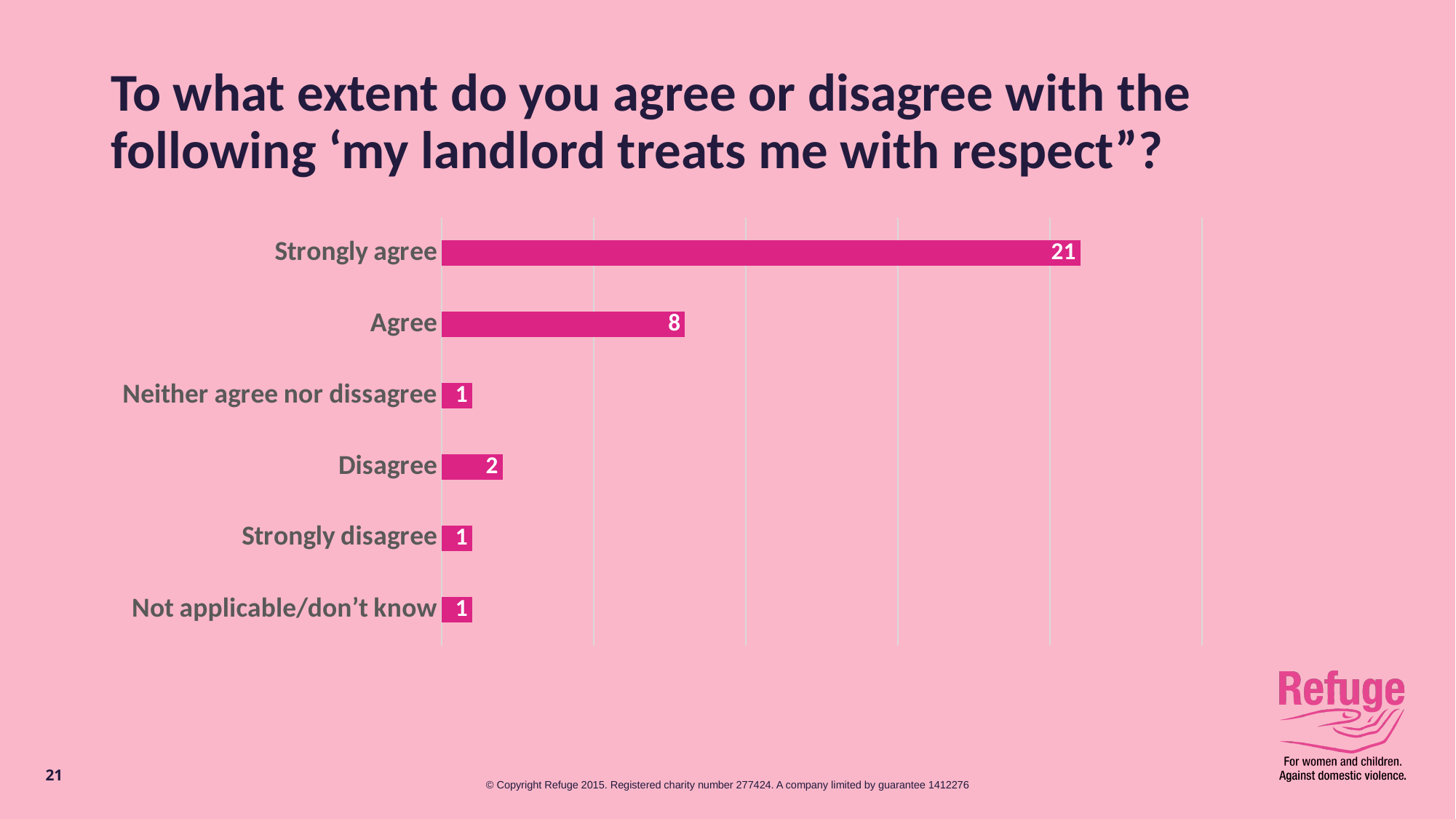
What is the difference between the values for Disagree and Strongly disagree? 1 What is the value for Disagree? 2 What is the value for Agree? 8 How many categories are shown in the chart? 6 What is the difference between the values for Strongly agree and Agree? 13 What kind of chart is shown on the slide? Bar chart What is the value for Not applicable/don't know? 1 Which is larger, the value for Agree or the value for Disagree? Agree What is the total of all the values shown in the chart? 34 What is the value for Strongly agree? 21 What colour are the bars in the chart? Pink Which category has the highest value? Strongly agree